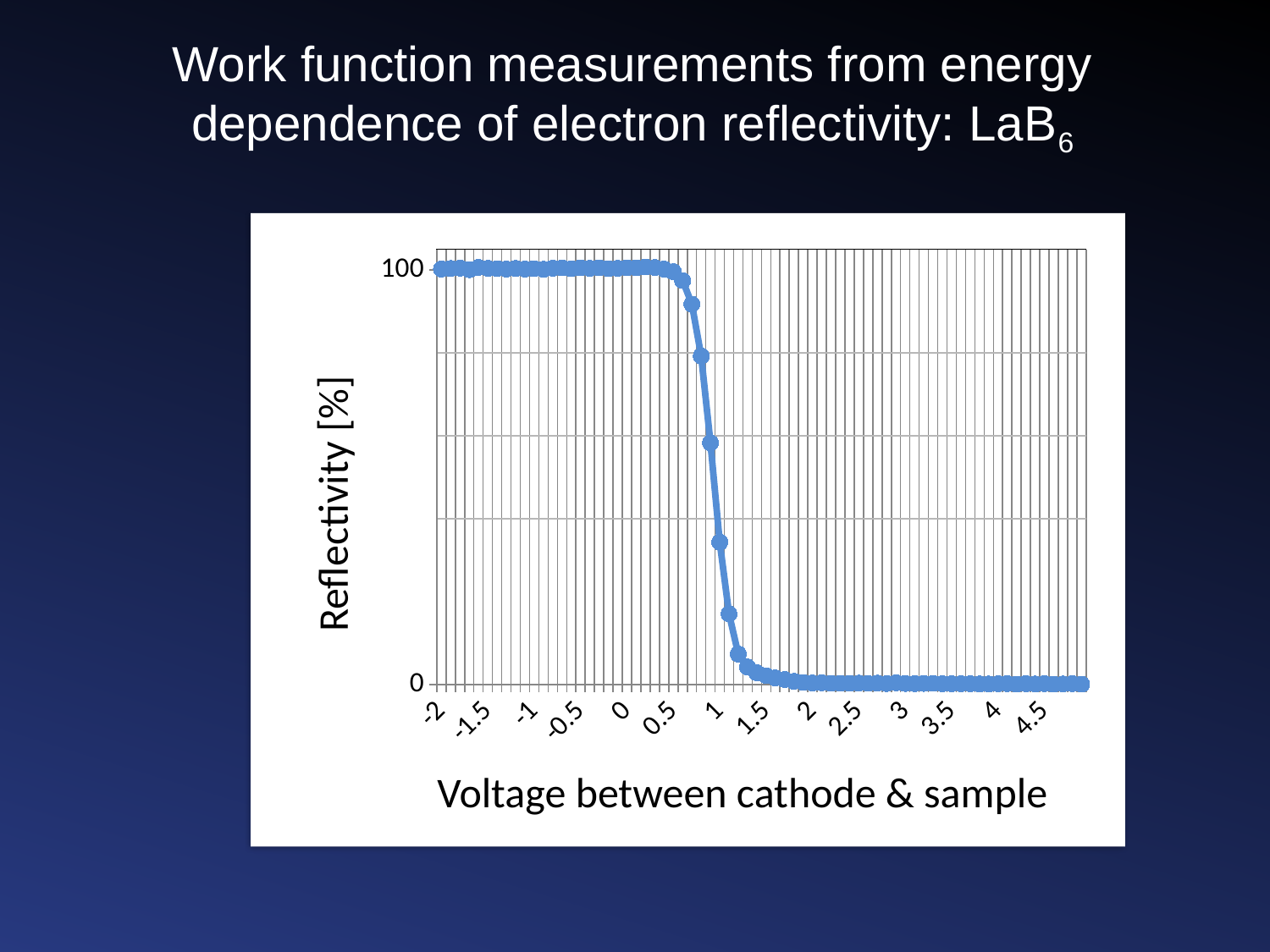
Is the reflectivity at a voltage of -2 greater or less than 0? greater Which has the lower reflectivity: a voltage of 0 or a voltage of 2.5? 2.5 Which has the higher reflectivity: a voltage of -1 or a voltage of 3? -1 What kind of chart is shown on the slide? line chart Is the reflectivity at a voltage of 1.5 greater or less than 100? less Between which two labelled voltages does the reflectivity drop from near 100 to near 0? 0.5 and 1.5 Overall, does the reflectivity rise or fall as the voltage increases along the x axis? fall What is the label of the x axis? Voltage between cathode & sample Is the reflectivity at a voltage of 3 greater or less than 100? less What is the label of the y axis? Reflectivity [%]